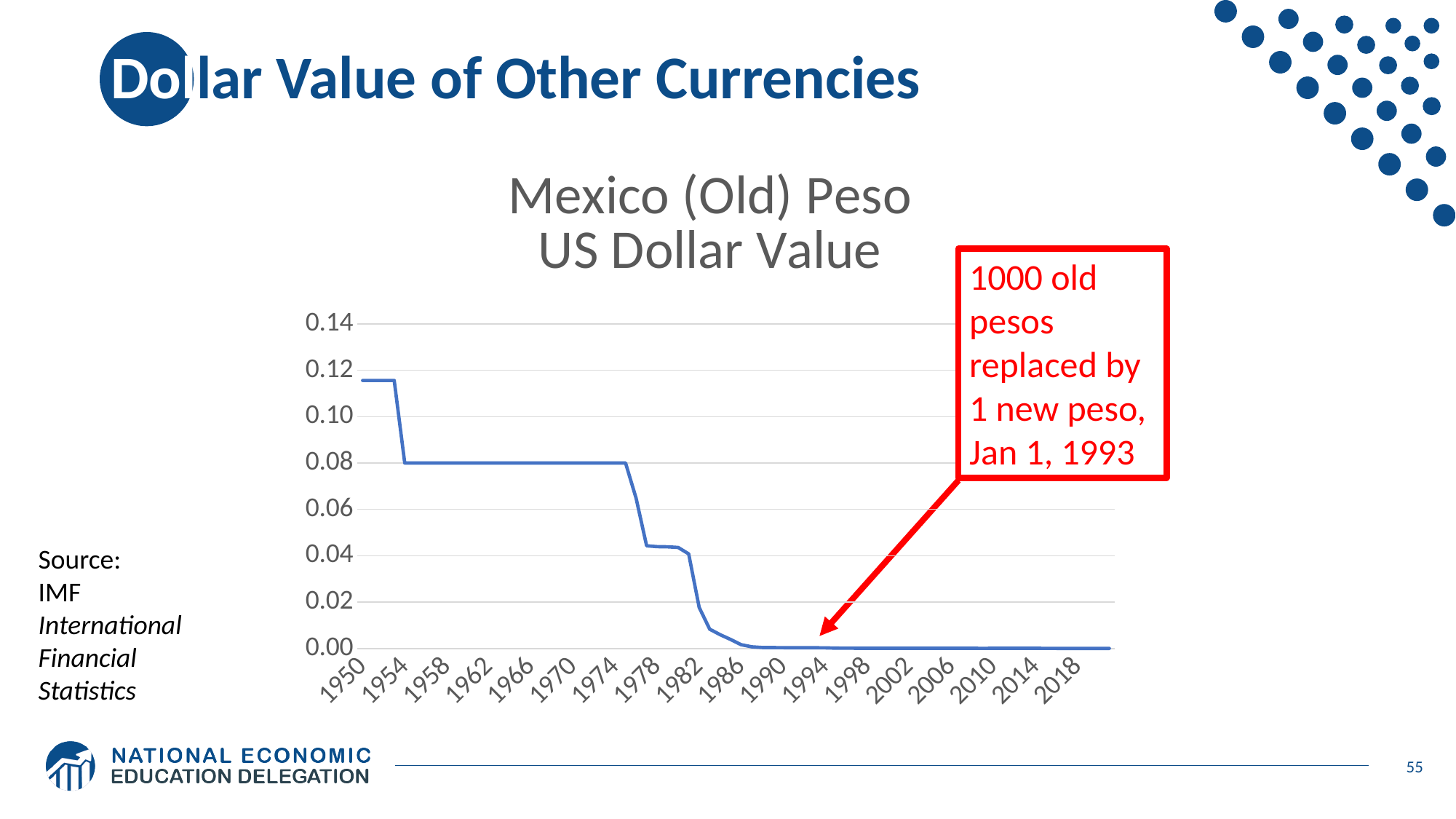
Is the value for 1978 greater or less than 0.06? less How many year labels are shown on the x axis? 18 Is the value for 1990 greater or less than 0.02? less Is the value for 1950 greater or less than 0.10? greater Do the values in the chart generally rise or fall from 1950 to 2018? fall Which year has a higher value, 1950 or 1982? 1950 According to the annotation on the chart, on what date were 1000 old pesos replaced by 1 new peso? Jan 1, 1993 What kind of chart is shown on the slide? line chart Which year has a higher value, 1970 or 1978? 1970 What is the title of the chart? Mexico (Old) Peso US Dollar Value